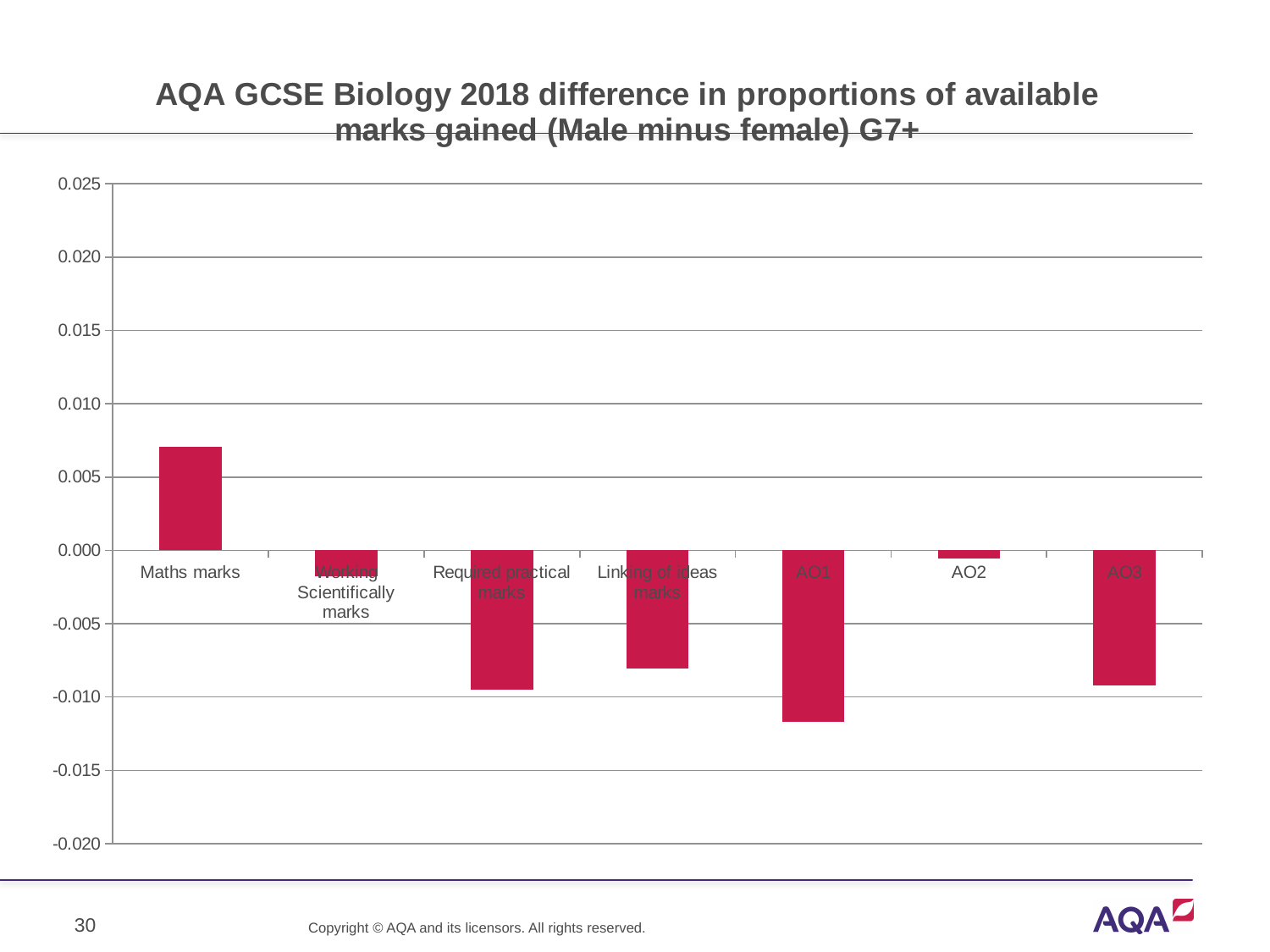
Is the value for Working Scientifically marks greater or less than -0.005? greater Which has the larger value, AO1 or AO2? AO2 How many categories are plotted on the chart? 7 What type of chart is shown on the slide? bar chart What is the title of the chart? AQA GCSE Biology 2018 difference in proportions of available marks gained (Male minus female) G7+ Is the value for AO2 greater or less than -0.005? greater Which category has the highest value? Maths marks Which category has the lowest value? AO1 Is the value for Required practical marks greater or less than -0.005? less Which has the larger value, Maths marks or AO3? Maths marks